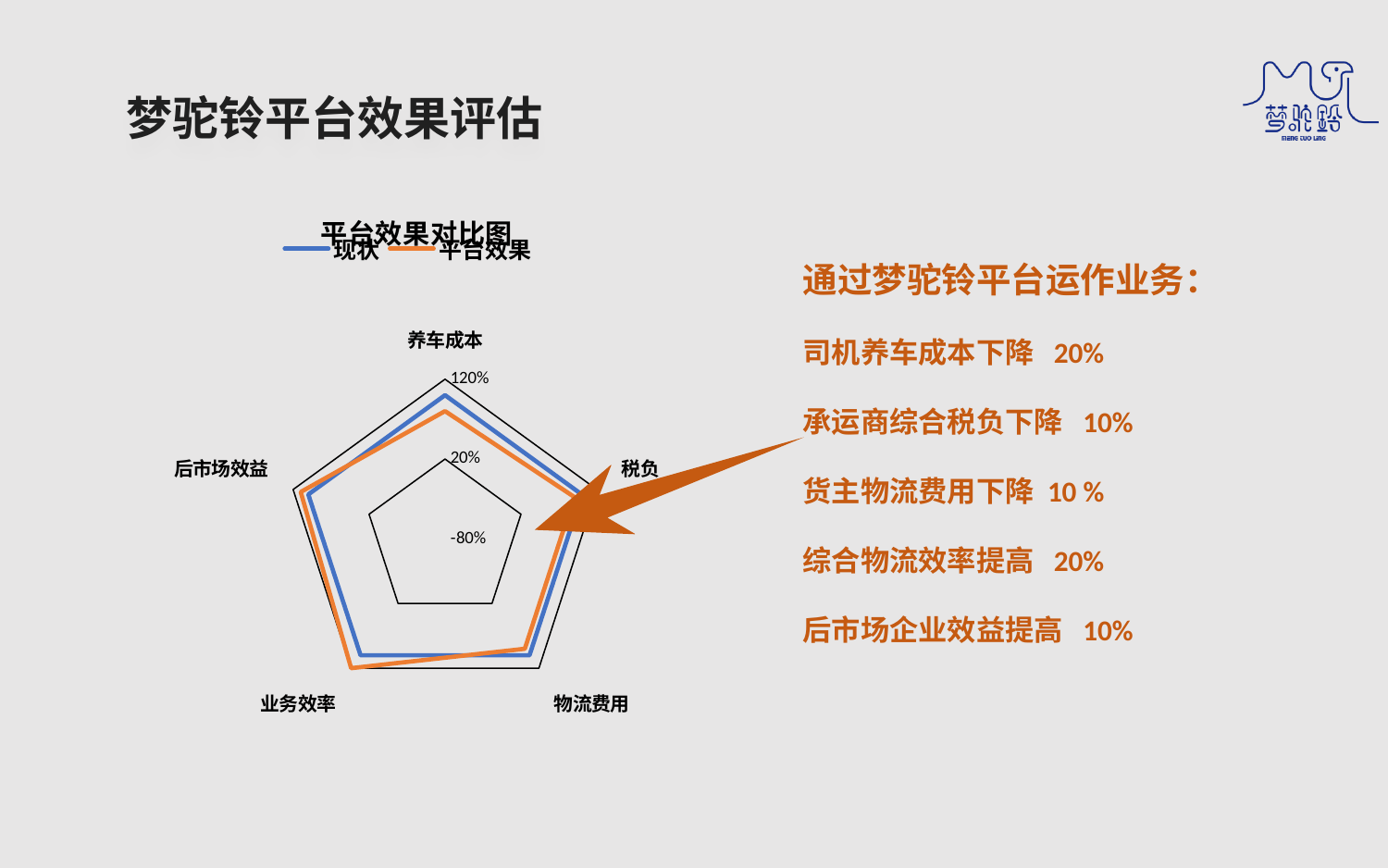
Is the 现状 value for 养车成本 greater or less than 20%? greater What is the title of the chart? 平台效果对比图 What are the two series named in the legend? 现状 and 平台效果 Is the 平台效果 value for 税负 greater or less than 20%? greater For 业务效率, which series has the larger value, 现状 or 平台效果? 平台效果 How many series does the chart legend list? 2 For 后市场效益, which series has the larger value, 现状 or 平台效果? 平台效果 What kind of chart is shown on the slide? radar chart How many categories (axes) does the radar chart have? 5 For 养车成本, which series has the larger value, 现状 or 平台效果? 现状 Is the 平台效果 value for 养车成本 greater or less than 120%? less